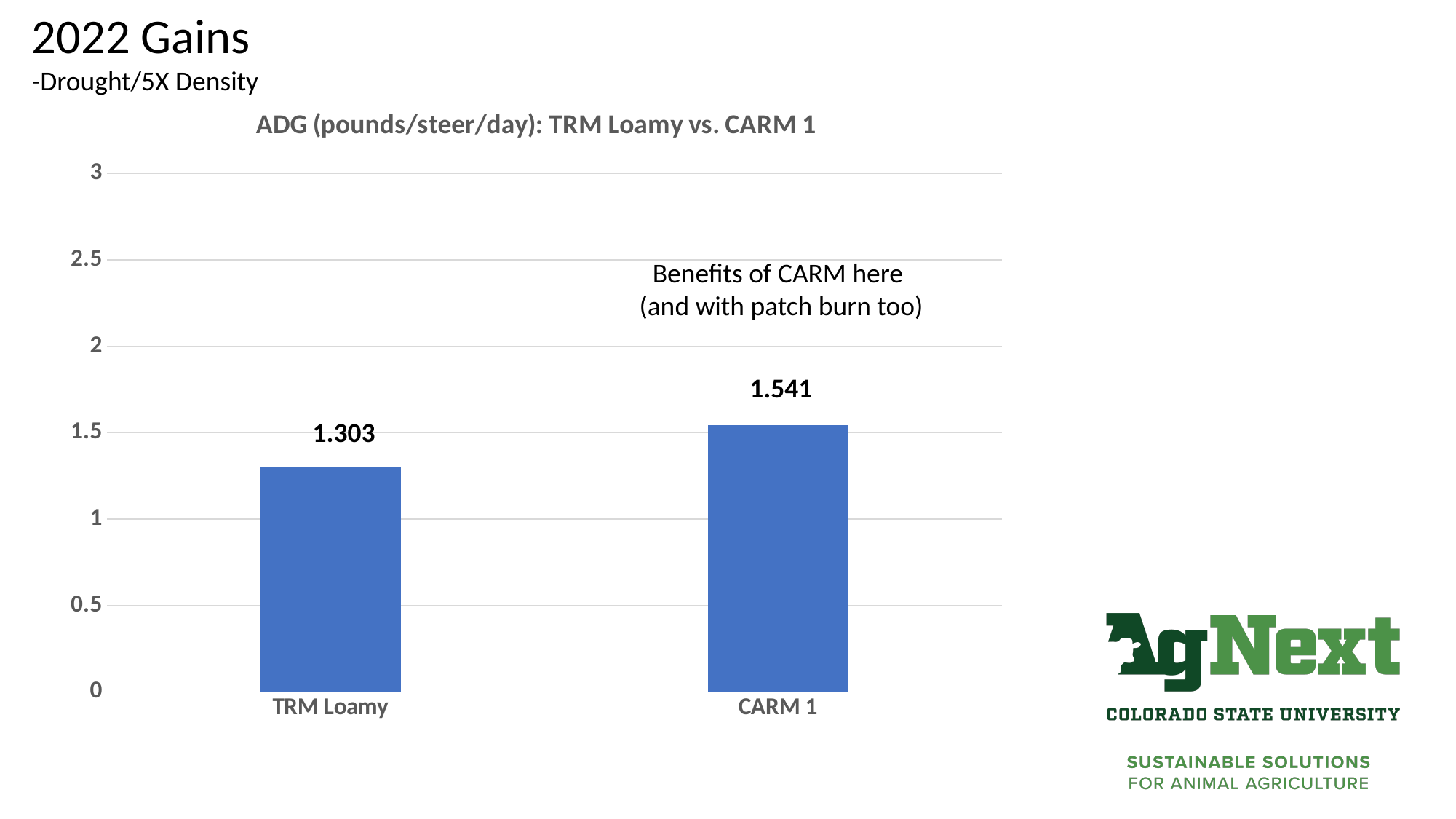
What is the title of the chart? ADG (pounds/steer/day): TRM Loamy vs. CARM 1 What is the highest value shown on the y axis? 3 What is the ADG value for CARM 1? 1.541 Which category has the higher ADG? CARM 1 What kind of chart is shown on the slide? bar chart Is the value for TRM Loamy greater or less than 1.5? less Is the value for CARM 1 greater or less than 1.5? greater What is the ADG value for TRM Loamy? 1.303 Which category has the lower ADG? TRM Loamy How many categories are shown in the chart? 2 What is the difference in ADG between CARM 1 and TRM Loamy? 0.238 Is the ADG for CARM 1 larger or smaller than the ADG for TRM Loamy? larger